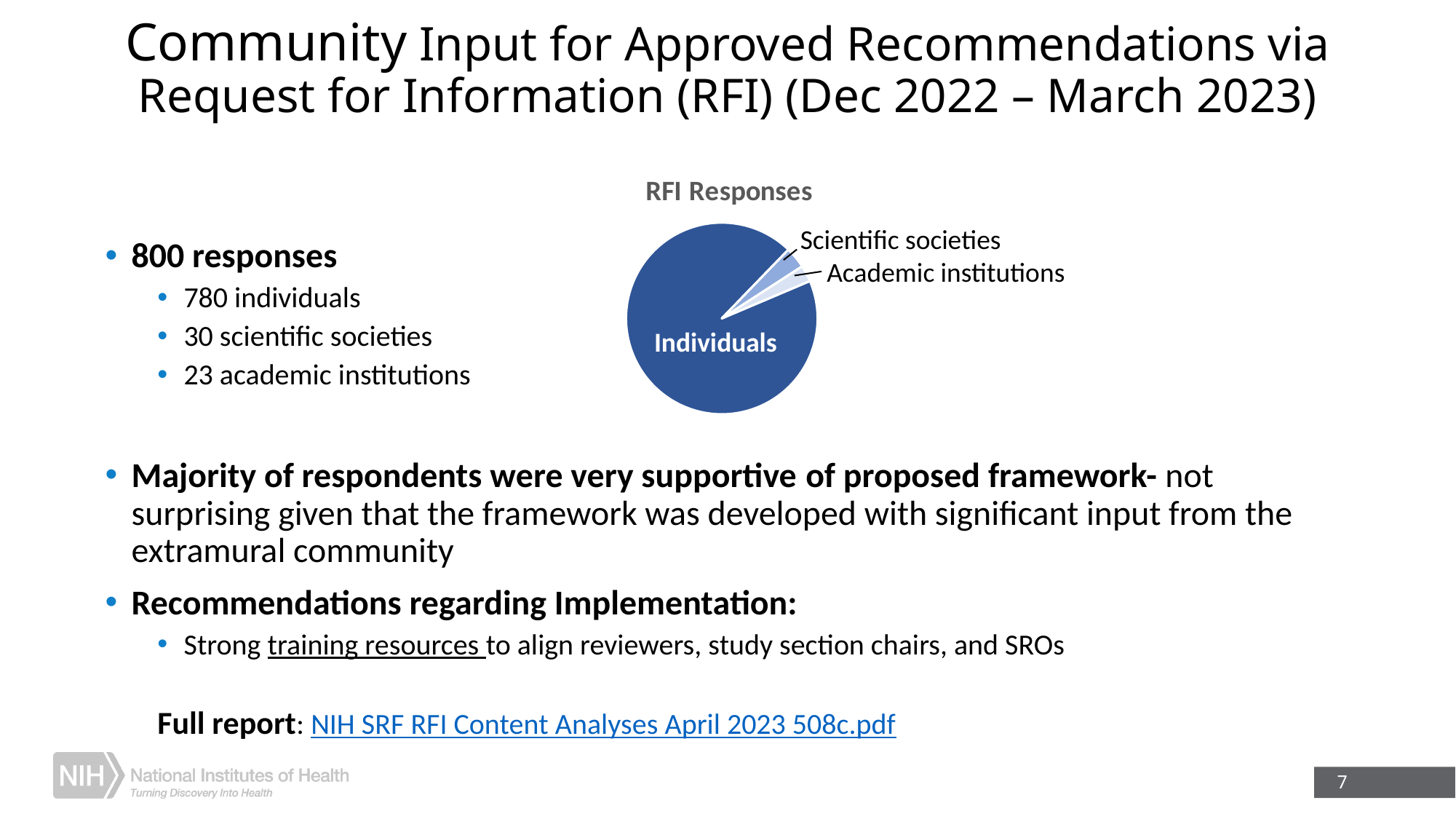
Which category makes up the largest slice of the RFI Responses pie chart? Individuals Which had more responses, scientific societies or academic institutions? Scientific societies What is the difference between the number of responses from scientific societies and from academic institutions? 7 How many responses came from scientific societies? 30 How many responses came from individuals? 780 How many slices does the RFI Responses pie chart have? 3 What is the title of the chart? RFI Responses How many responses came from academic institutions? 23 Which category makes up the smallest slice of the RFI Responses pie chart? Academic institutions What is the difference between the number of responses from individuals and from scientific societies? 750 What is the total number of RFI responses? 800 What kind of chart is shown on the slide? pie chart